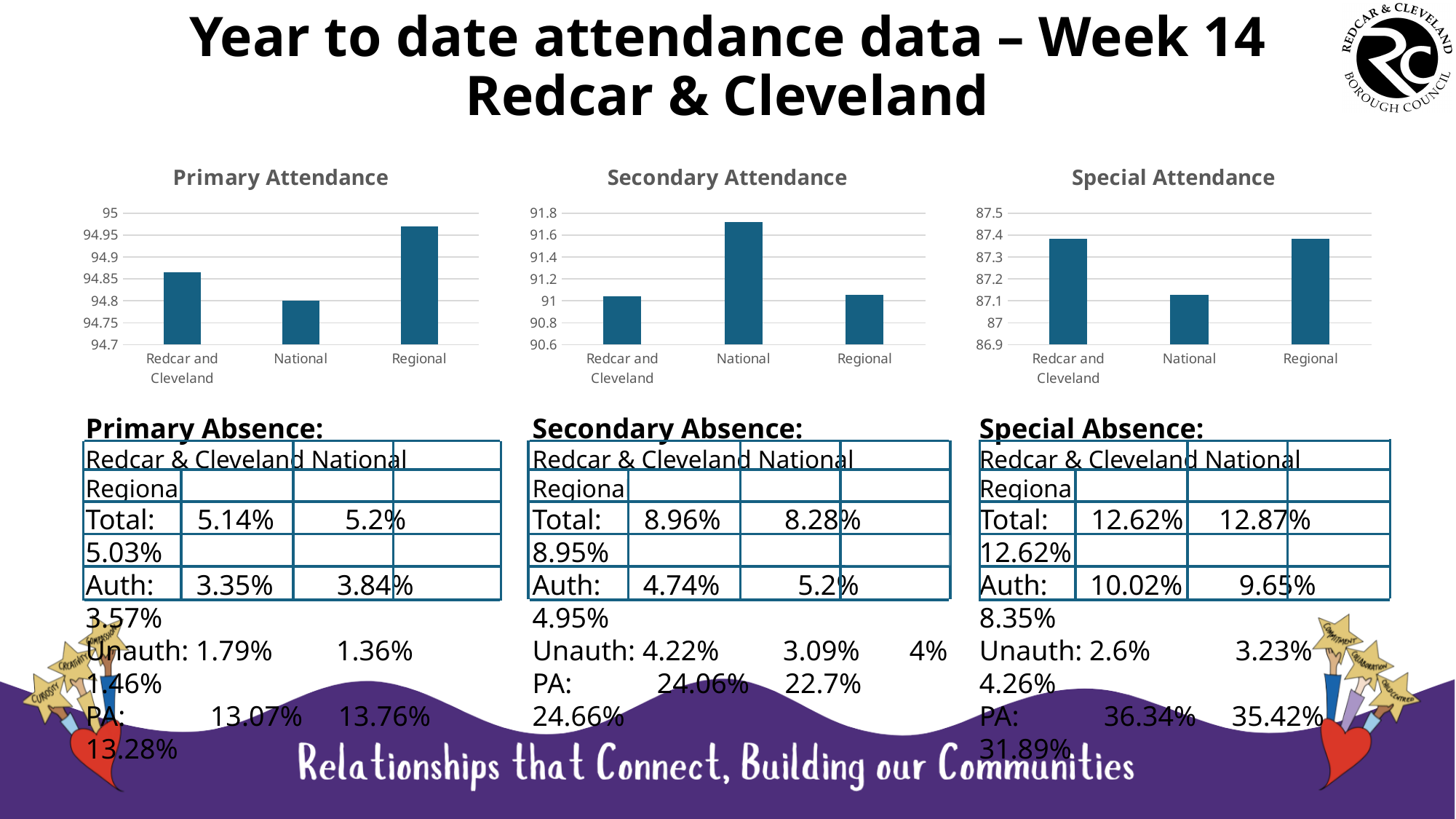
In the Special Attendance chart, which category has the lowest value? National In the Primary Attendance chart, is the value for Regional greater or less than 94.95? greater In the Special Attendance chart, is the value for Redcar and Cleveland greater or less than 87.3? greater In the Secondary Attendance chart, is the value for National greater or less than 91.6? greater What kind of chart is the Special Attendance chart? bar chart How many categories are shown on the x axis of the Secondary Attendance chart? 3 In the Secondary Attendance chart, which category has the highest value? National In the Primary Attendance chart, which category has the lowest value? National In the Primary Attendance chart, which category has the highest value? Regional